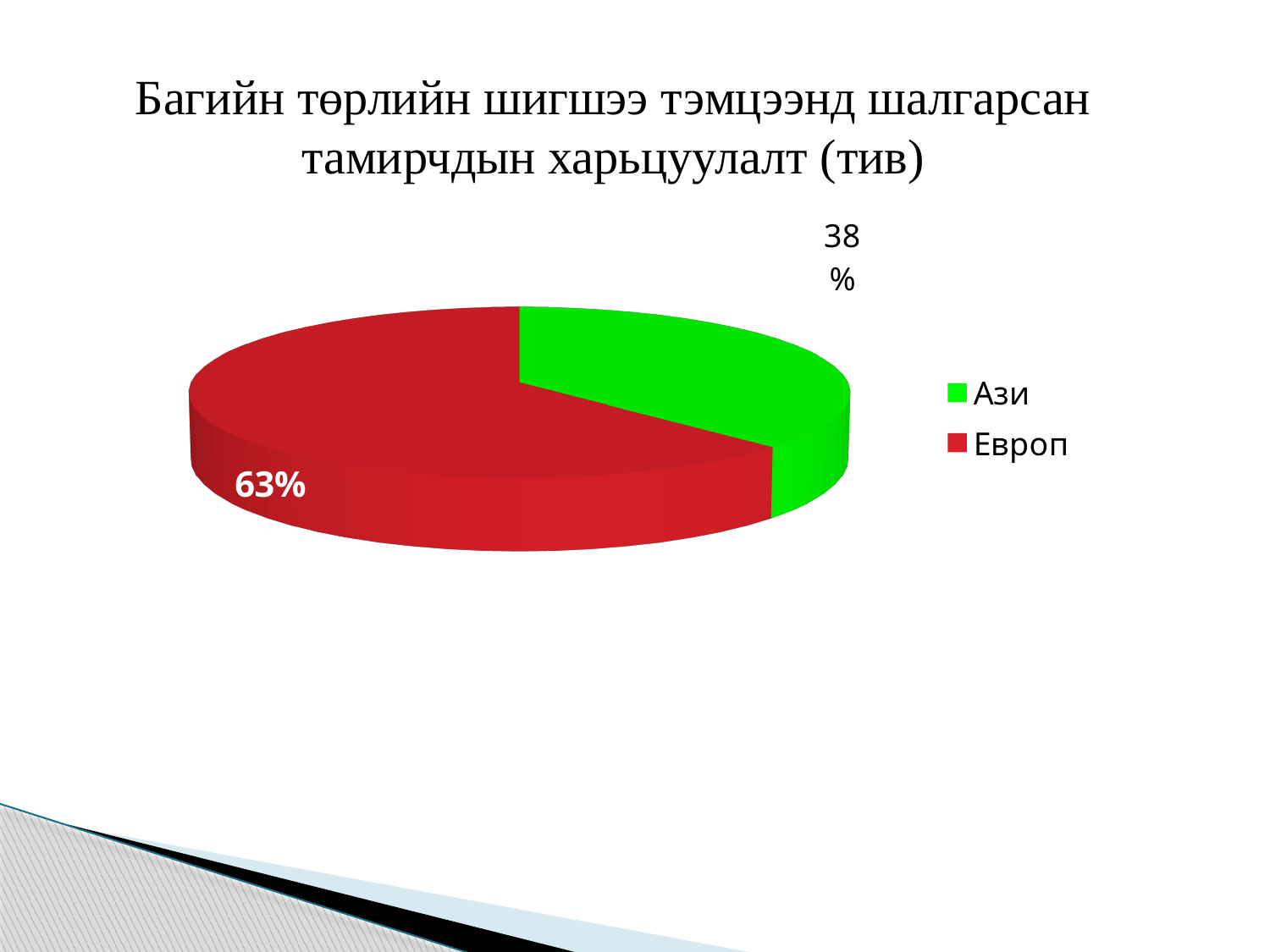
By how many percentage points does the Европ slice exceed the Ази slice? 25 What colour is the slice for Европ? red How many categories are shown in the pie chart? 2 Which category has the smallest slice of the pie? Ази How many entries does the legend list? 2 Which is larger, the slice for Ази or the slice for Европ? Европ What share of the pie does Европ have? 63% What colour is the slice for Ази? green Is the share for Европ greater or less than 50%? greater Which category has the largest slice of the pie? Европ What kind of chart is shown on the slide? pie chart What share of the pie does Ази have? 38%